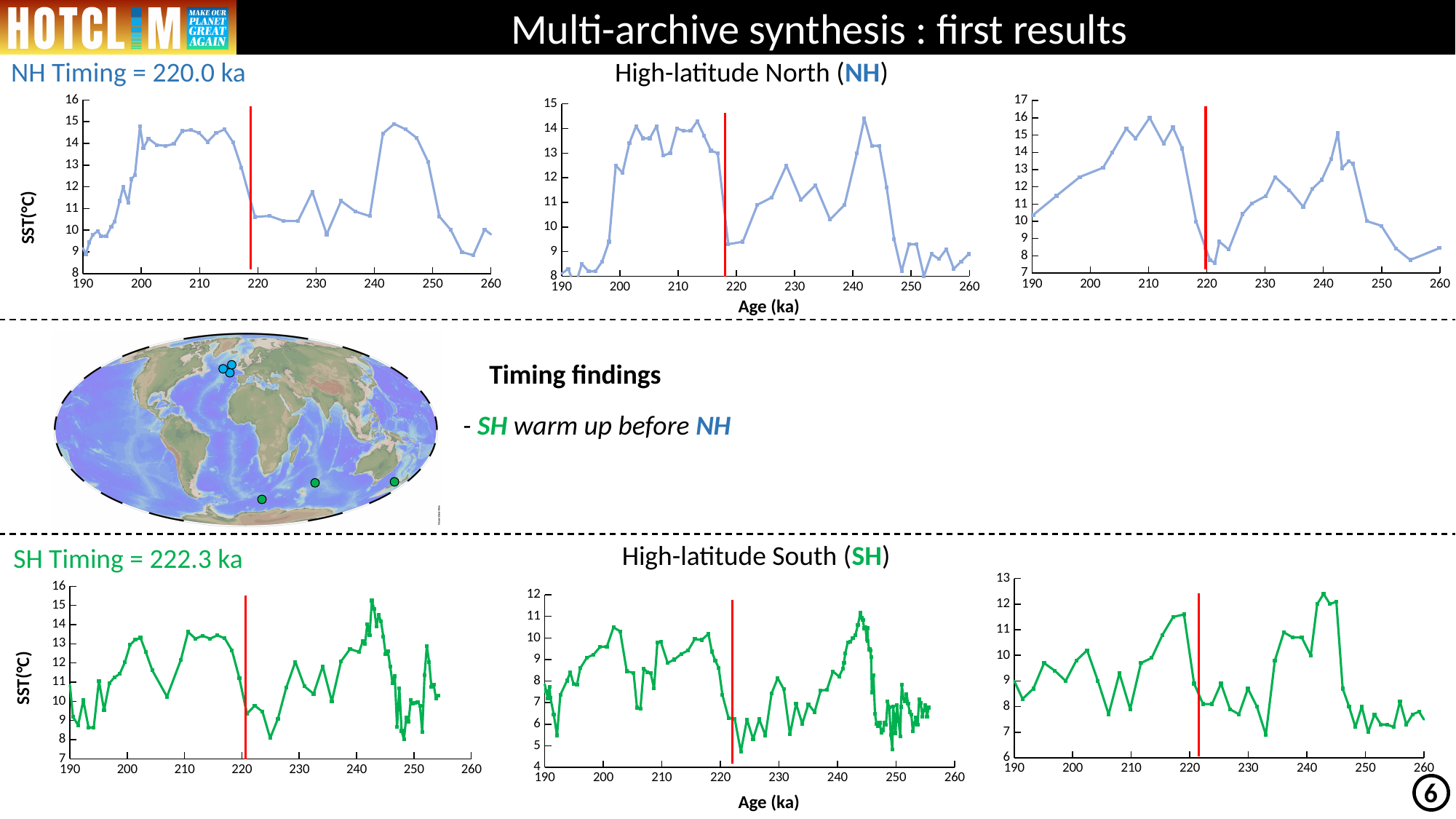
In the top-left NH chart, does the line rise or fall between 190 ka and 200 ka? rise In the top-left NH chart, is the value at 190 ka greater or less than 10? less What kind of chart is the top-left chart under 'High-latitude North (NH)'? line chart How many line charts are shown on the slide in total? 6 In the top-right NH chart, is the value at 210 ka greater or less than 15? greater In the top-right NH chart, at which age on the x axis does the line reach its highest value? 210 What is the y-axis label of the left-hand charts? SST(°C) In the top-left NH chart, which is larger: the value at 200 ka or the value at 190 ka? 200 ka In the bottom-middle SH chart, does the line rise or fall between 244 ka and 250 ka? fall In the bottom-right SH chart, is the value at 243 ka greater or less than 11? greater What is the x-axis label of the charts on the slide? Age (ka)